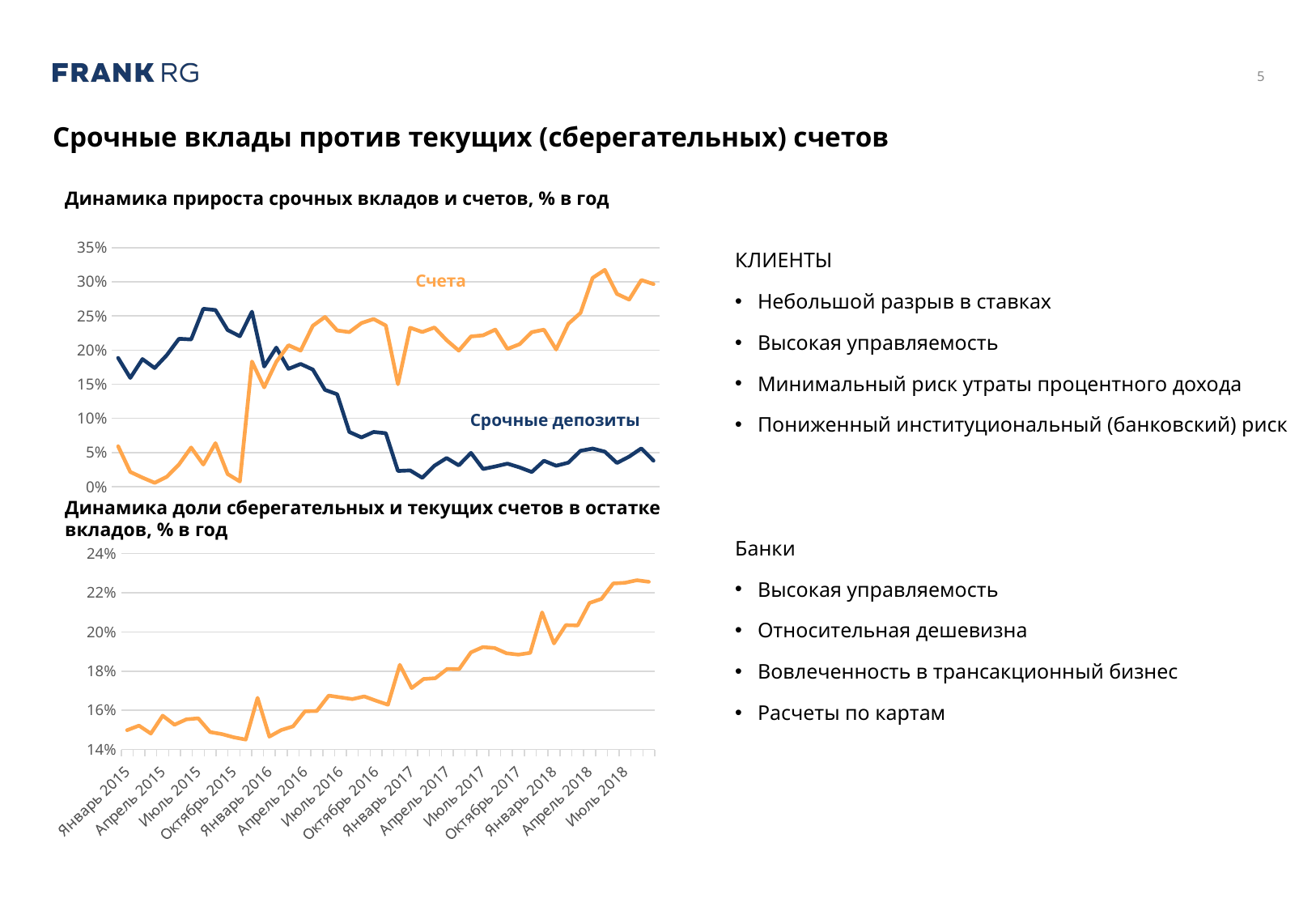
On the top chart, which series is higher at Январь 2015: 'Счета' or 'Срочные депозиты'? Срочные депозиты On the bottom chart 'Динамика доли сберегательных и текущих счетов в остатке вкладов, % в год', does the line rise or fall from Январь 2015 to Июль 2018? Rise How many series are plotted on the top chart 'Динамика прироста срочных вкладов и счетов, % в год'? 2 On the bottom chart 'Динамика доли сберегательных и текущих счетов в остатке вкладов, % в год', is the value at Июль 2018 greater or less than 20%? greater On the top chart, what colour is the 'Срочные депозиты' line? Dark blue What kind of chart is the top chart titled 'Динамика прироста срочных вкладов и счетов, % в год'? Line chart On the top chart, which series is higher at Июль 2018: 'Счета' or 'Срочные депозиты'? Счета On the top chart, does the 'Срочные депозиты' line rise or fall from Январь 2015 to Июль 2018? Fall On the top chart, does the 'Счета' line rise or fall overall from Январь 2015 to Июль 2018? Rise On the top chart, what are the names of the two plotted series? Счета and Срочные депозиты On the top chart, is the value for 'Счета' at Июль 2018 greater or less than 25%? greater On the top chart, is the value for 'Срочные депозиты' at Июль 2018 greater or less than 10%? less